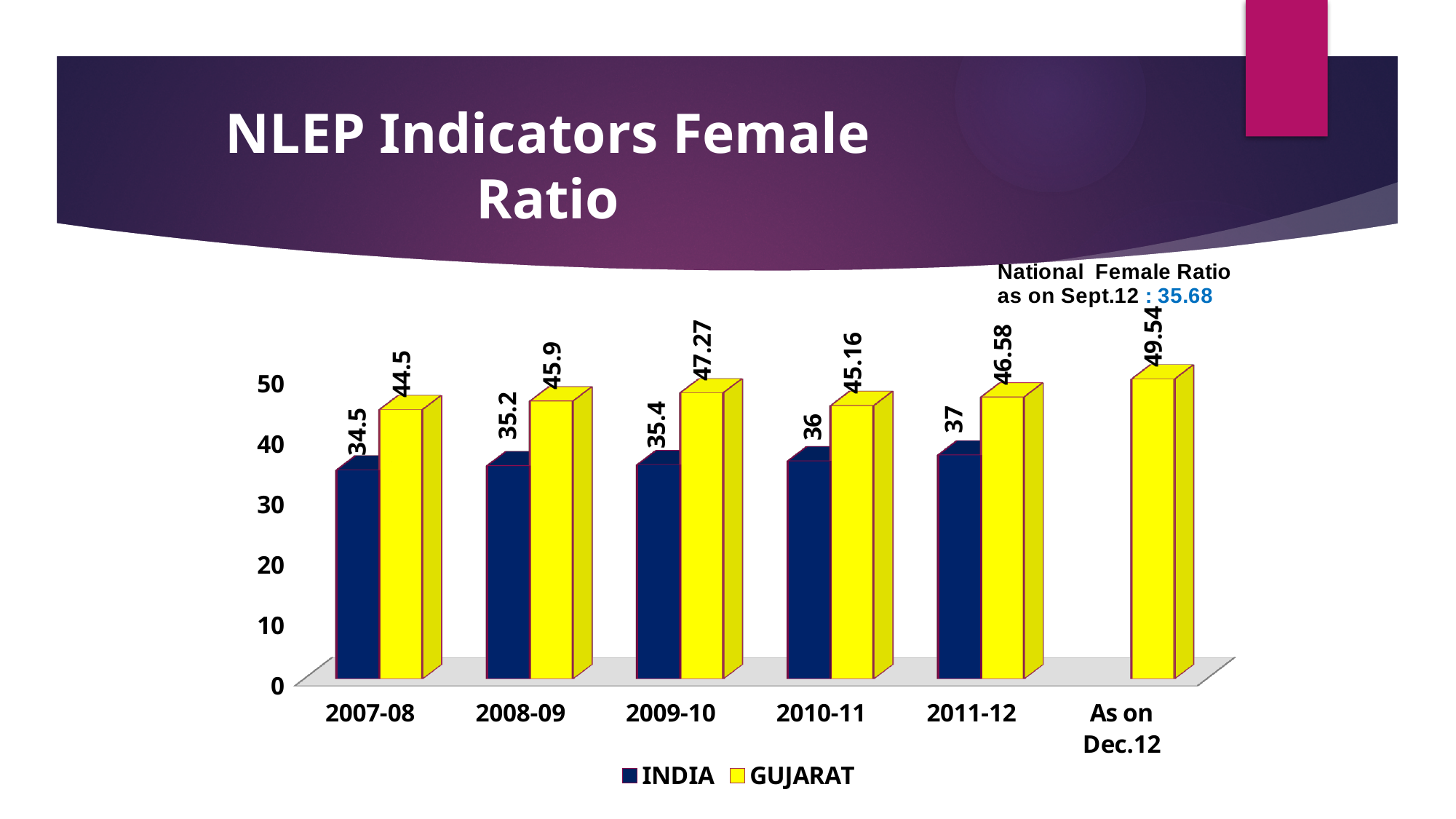
What is the value for GUJARAT for 'As on Dec.12'? 49.54 Do the INDIA values rise or fall from 2007-08 to 2011-12? Rise Which is larger in 2010-11, the INDIA value or the GUJARAT value? GUJARAT How many categories are shown on the x axis? 6 What is the value for INDIA in 2011-12? 37 Which category has the highest GUJARAT value? As on Dec.12 How many series does the legend list? 2 What colour are the GUJARAT bars? Yellow What kind of chart is shown on the slide? Bar chart What is the value for GUJARAT in 2009-10? 47.27 Which category has the lowest INDIA value? 2007-08 What is the difference between the GUJARAT and INDIA values in 2007-08? 10